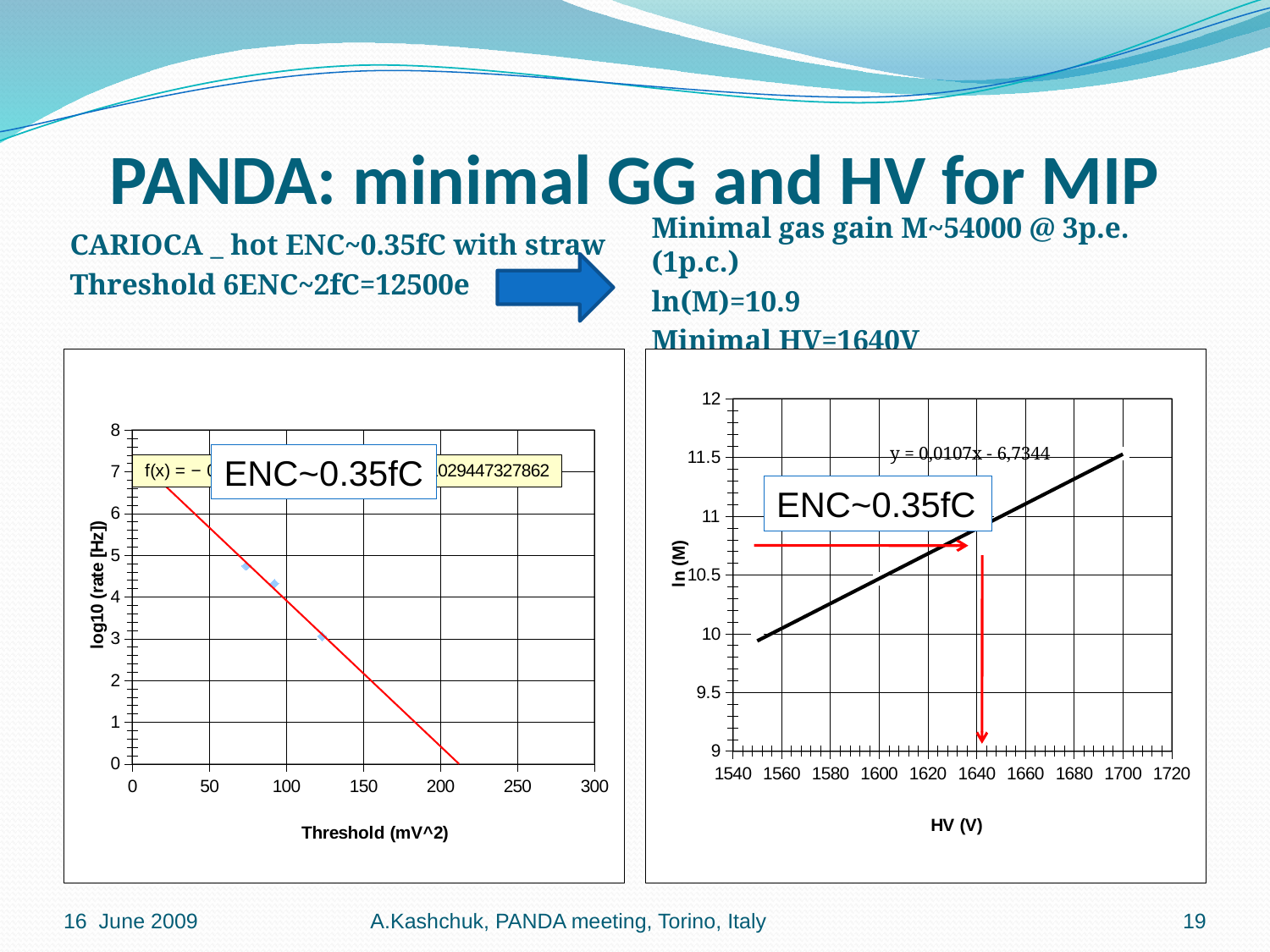
What fit equation is printed on the right chart? y = 0,0107x - 6,7344 What is the x-axis title of the right chart? HV (V) On the right chart, is the value of ln (M) at HV = 1680 V greater or less than 11? greater On the right chart, does ln (M) rise or fall as HV increases? rise On the left chart, is the highest plotted data point greater or less than 4 on the log10 (rate [Hz]) axis? greater On the left chart, is the lowest plotted data point greater or less than 4 on the log10 (rate [Hz]) axis? less What kind of chart is the right chart (ln(M) vs HV)? line chart What kind of chart is the left chart (log10 rate vs Threshold)? scatter plot with a fitted line How many data points are plotted on the left chart? 3 On the left chart, does log10 (rate [Hz]) rise or fall as Threshold increases? fall